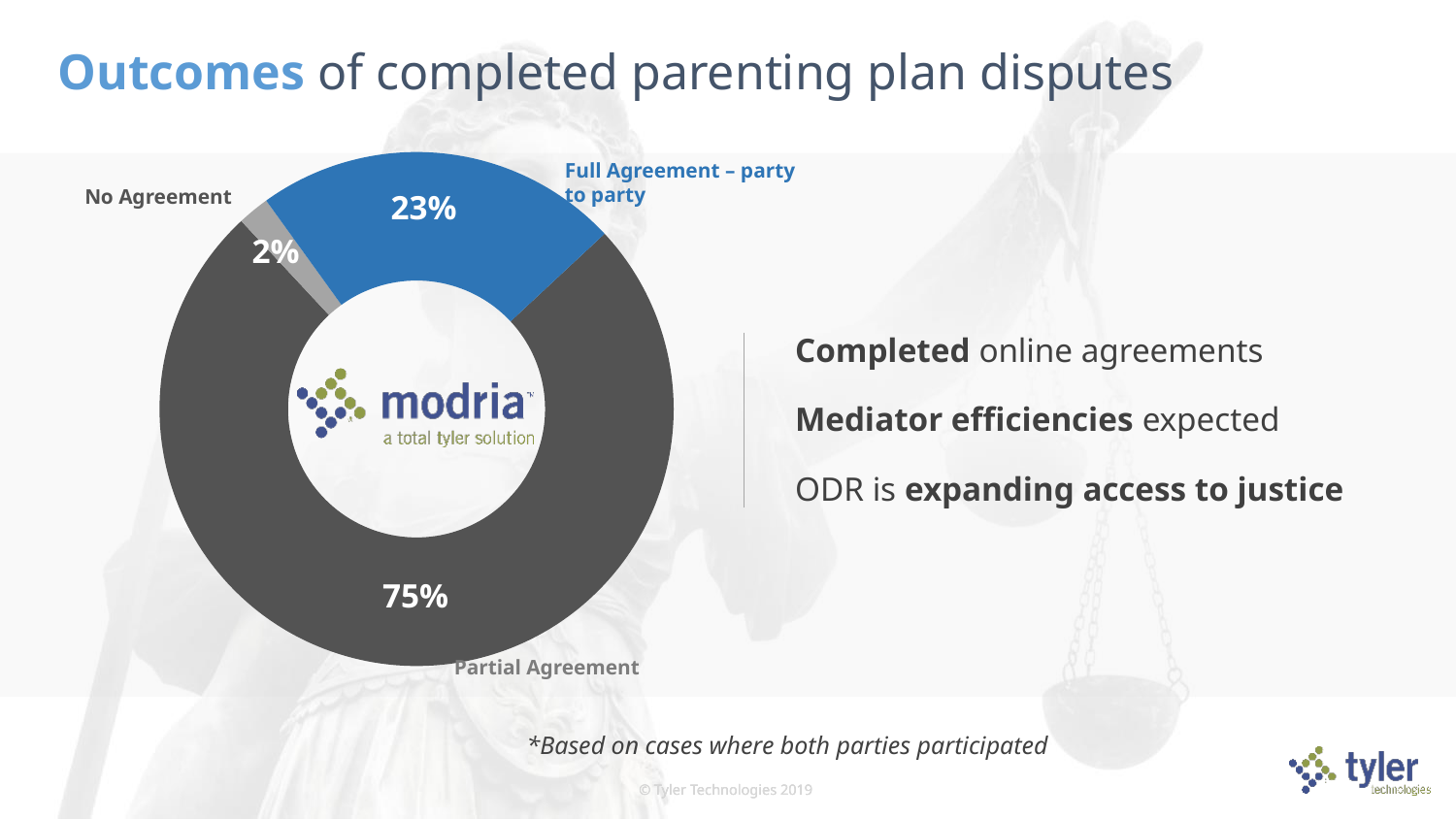
What share of completed parenting plan disputes ended in Partial Agreement? 75% What is the difference in percentage points between Full Agreement – party to party and No Agreement? 21 How many outcome categories are shown in the chart? 3 What share of completed parenting plan disputes ended in No Agreement? 2% What is the title of the slide containing the chart? Outcomes of completed parenting plan disputes What is the difference in percentage points between Partial Agreement and Full Agreement – party to party? 52 What colour is the Full Agreement – party to party slice? Blue Which outcome has the largest share of the chart? Partial Agreement Which is larger: the share for Full Agreement – party to party or the share for No Agreement? Full Agreement – party to party What kind of chart is shown on the slide? Pie chart (doughnut) Which outcome has the smallest share of the chart? No Agreement What share of completed parenting plan disputes ended in Full Agreement – party to party? 23%